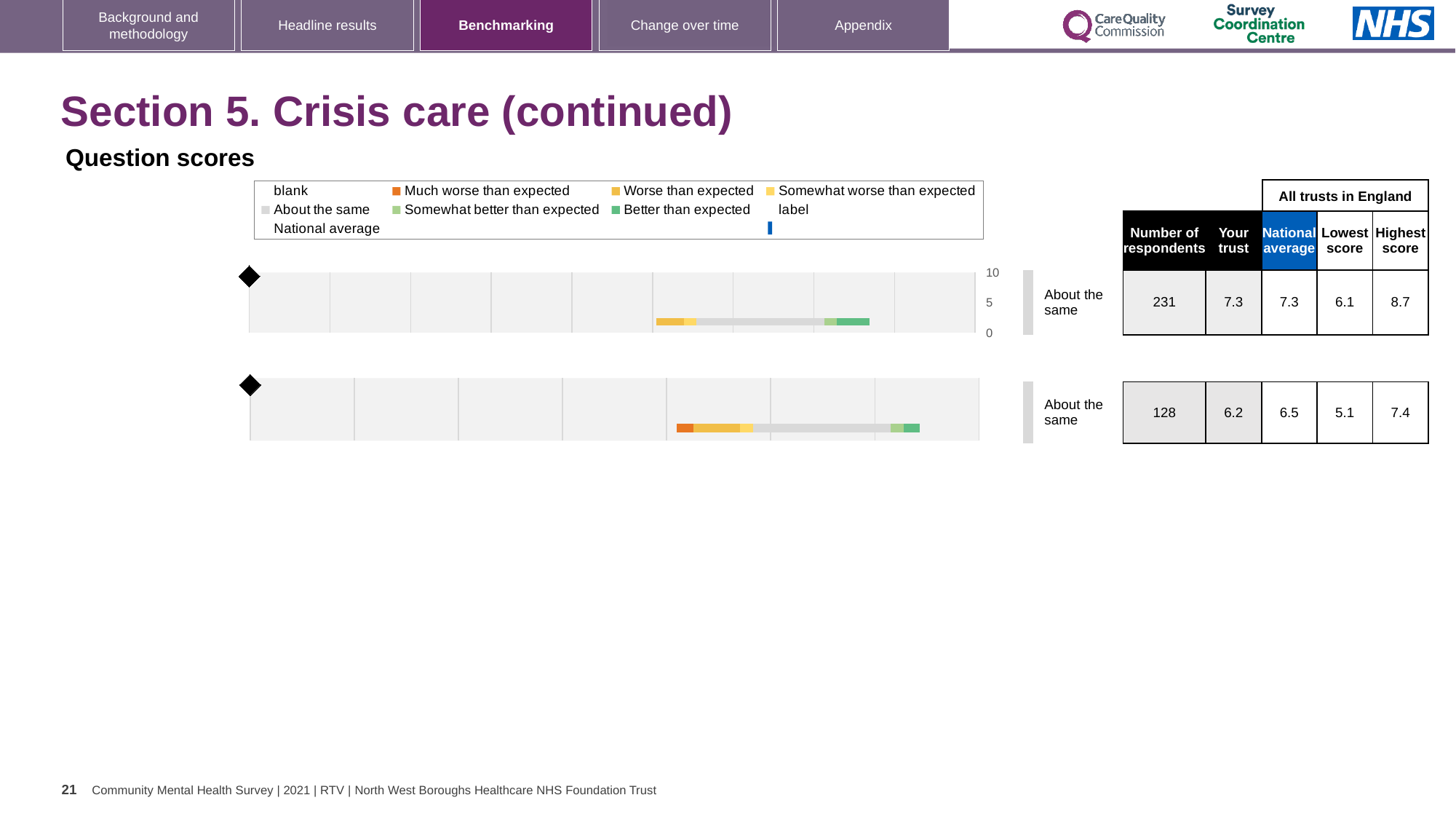
For the bottom chart, which is larger: the 'Your trust' score or the national average? National average For the top chart, what is the 'Your trust' score? 7.3 What benchmark category is shown next to the bottom chart? About the same For the bottom chart, what is the 'Your trust' score? 6.2 What kind of chart is used on this slide to show the question scores? bar chart What is the maximum value shown on the vertical axis of the top chart? 10 For the top chart, what is the number of respondents shown in the table? 231 For the bottom chart, what is the lowest score among all trusts in England? 5.1 How many question score charts are shown on the slide? 2 For the top chart, what is the difference between the highest score and the lowest score among all trusts in England? 2.6 For the top chart, what is the highest score among all trusts in England? 8.7 For the bottom chart, what is the national average score? 6.5